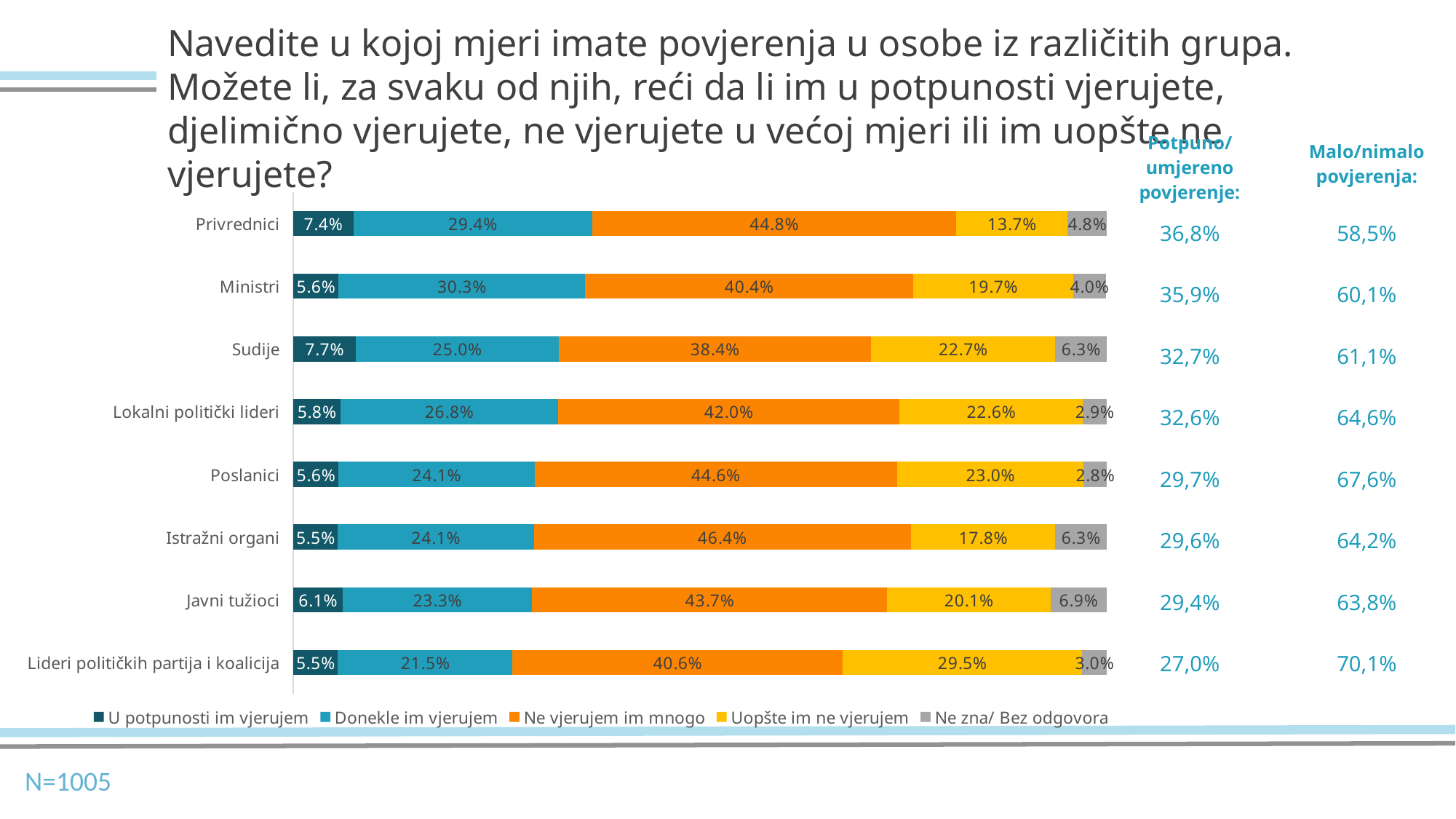
What type of chart is shown on the slide? Stacked bar chart What percentage of respondents answered "Ne vjerujem im mnogo" for Privrednici? 44.8% Which category has the lowest value for "Donekle im vjerujem"? Lideri političkih partija i koalicija What is the "Ne zna/ Bez odgovora" value for Javni tužioci? 6.9% Which category has the highest value for "U potpunosti im vjerujem"? Sudije What is the "Potpuno/umjereno povjerenje" value shown for Ministri? 35,9% What is the value of "Uopšte im ne vjerujem" for Lideri političkih partija i koalicija? 29.5% Which is larger: the "Ne vjerujem im mnogo" value for Istražni organi or for Sudije? Istražni organi Which category has the highest "Uopšte im ne vjerujem" value? Lideri političkih partija i koalicija How many categories (groups) are shown in the chart? 8 How many series does the legend list? 5 What is the difference between the "Donekle im vjerujem" values for Privrednici and Lideri političkih partija i koalicija? 7.9 percentage points